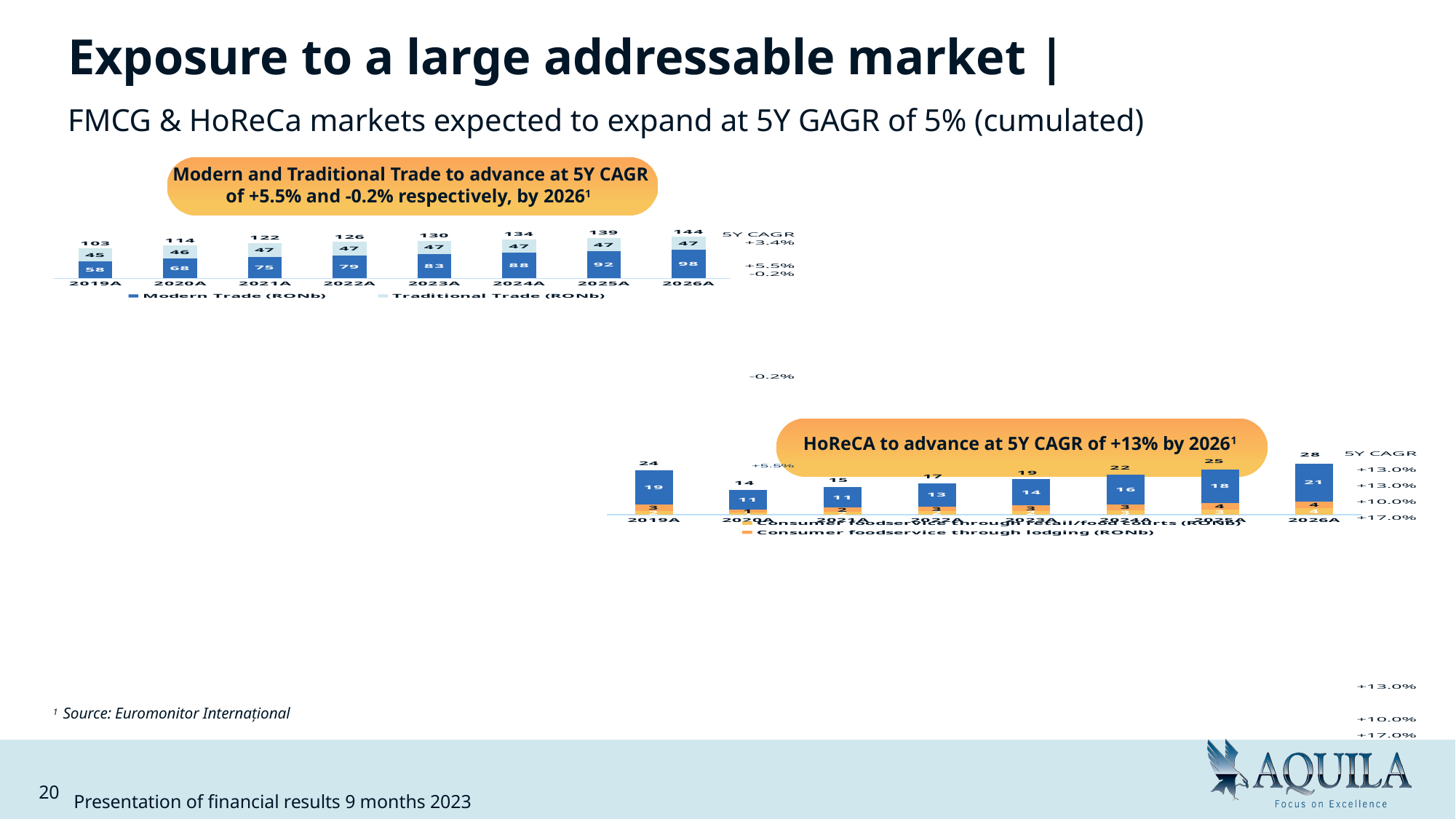
In the top-left chart (Modern and Traditional Trade), do the Modern Trade values rise or fall from 2019A to 2026A? rise In the top-left chart (Modern and Traditional Trade), what is the Traditional Trade value for 2019A? 45 In the bottom-right chart (HoReCa), what is the value for consumer foodservice through retail/food courts in 2026A? 4 In the top-left chart (Modern and Traditional Trade), how many series does the legend list? 2 In the bottom-right chart (HoReCa), which year has the lowest total shown above the bars? 2020A In the top-left chart (Modern and Traditional Trade), what is the Modern Trade value for 2026A? 98 In the bottom-right chart (HoReCa), what is the value for consumer foodservice through lodging in 2025A? 4 In the bottom-right chart (HoReCa), how many years are shown on the x axis? 8 In the top-left chart (Modern and Traditional Trade), which year has the highest total? 2026A In the top-left chart (Modern and Traditional Trade), what is the total of the stacked bar for 2023A? 130 In the top-left chart (Modern and Traditional Trade), what is the difference between the Modern Trade values for 2026A and 2019A? 40 What kind of chart is the bottom-right chart (HoReCa)? stacked bar chart